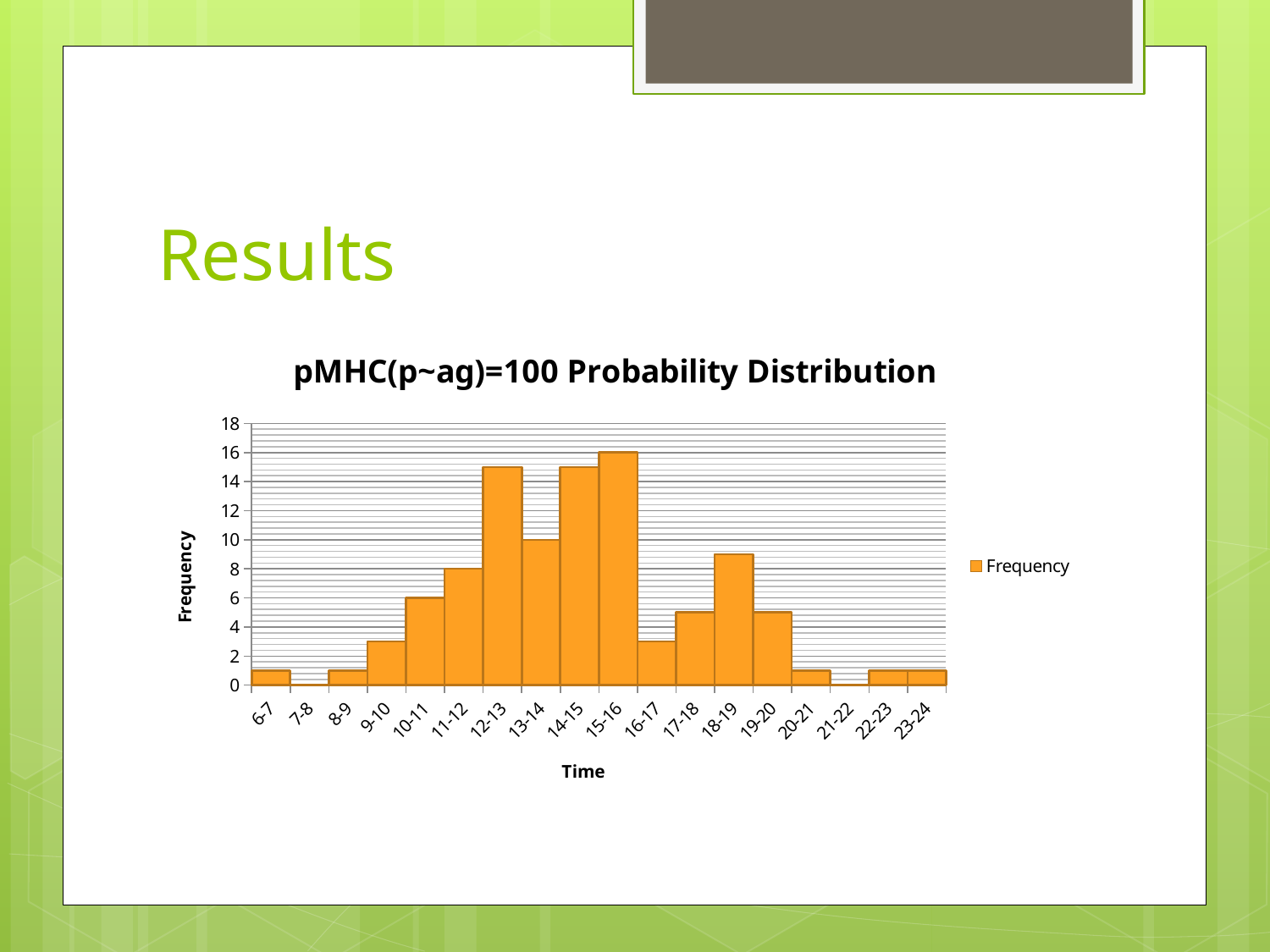
Is the frequency for the 18-19 bin greater or less than 10? less Is the frequency for the 12-13 bin greater or less than 14? greater How many series does the legend list? 1 How many time bins are shown on the x axis? 18 What is the difference in frequency between the 15-16 bin and the 13-14 bin? 6 What is the frequency for the 10-11 time bin? 6 What is the frequency for the 15-16 time bin? 16 What type of chart is shown on the slide? bar chart What is the frequency for the 13-14 time bin? 10 Which has a higher frequency, the 12-13 bin or the 13-14 bin? 12-13 Which time bin has the highest frequency? 15-16 What is the title of the chart? pMHC(p~ag)=100 Probability Distribution